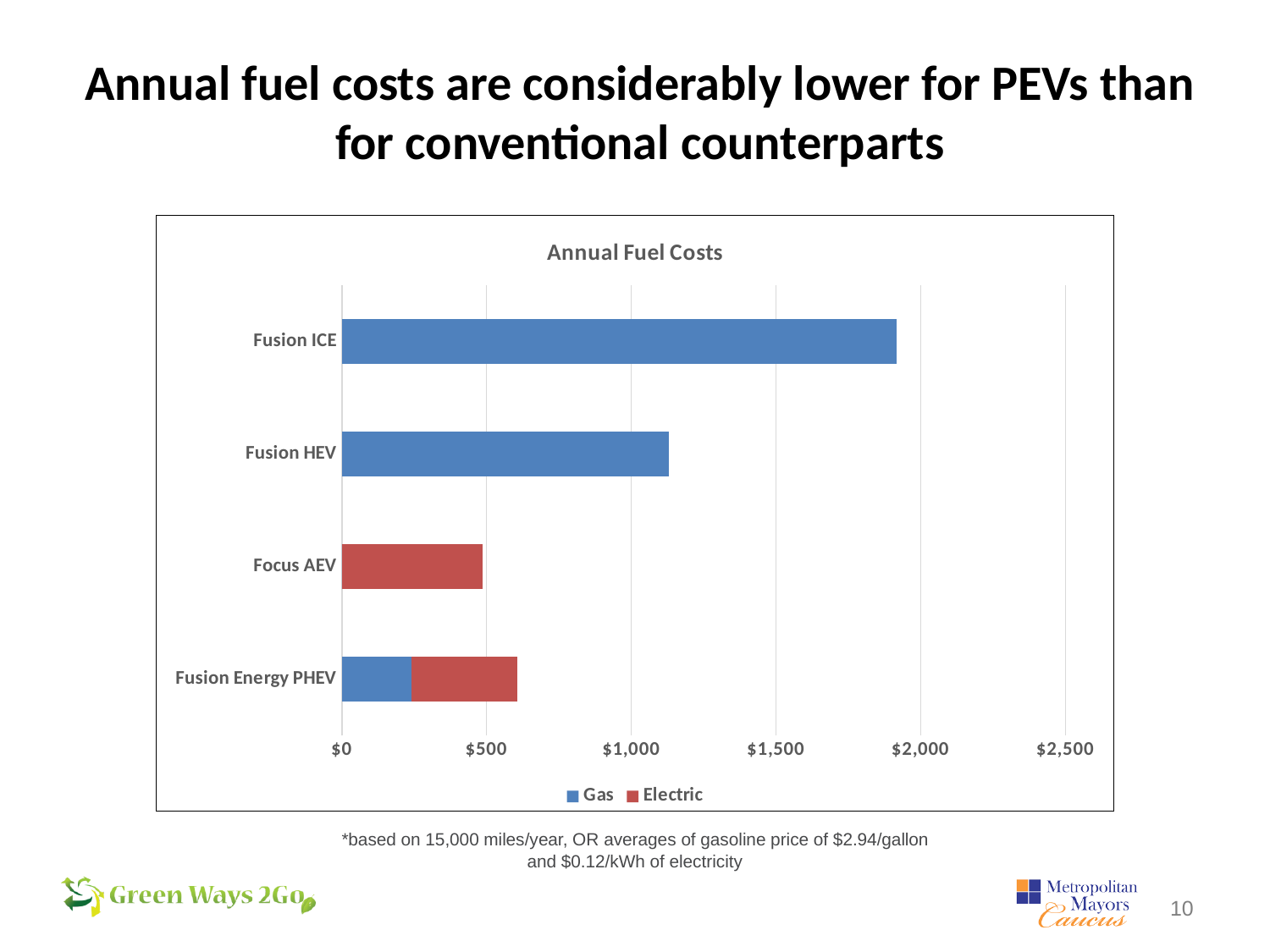
How many vehicle categories are shown in the chart? 4 Which vehicle has the lowest annual fuel cost? Focus AEV Is the annual fuel cost for Fusion HEV greater or less than $1,000? greater What kind of chart is shown on the slide? bar chart Which vehicle has the highest annual fuel cost? Fusion ICE Is the annual fuel cost for Focus AEV greater or less than $1,000? less Is the total annual fuel cost for Fusion Energy PHEV greater or less than $1,000? less How many series does the legend list? 2 Which vehicle's bar includes both Gas and Electric segments? Fusion Energy PHEV What is the title of the chart? Annual Fuel Costs Which has a higher annual fuel cost, Fusion HEV or Focus AEV? Fusion HEV